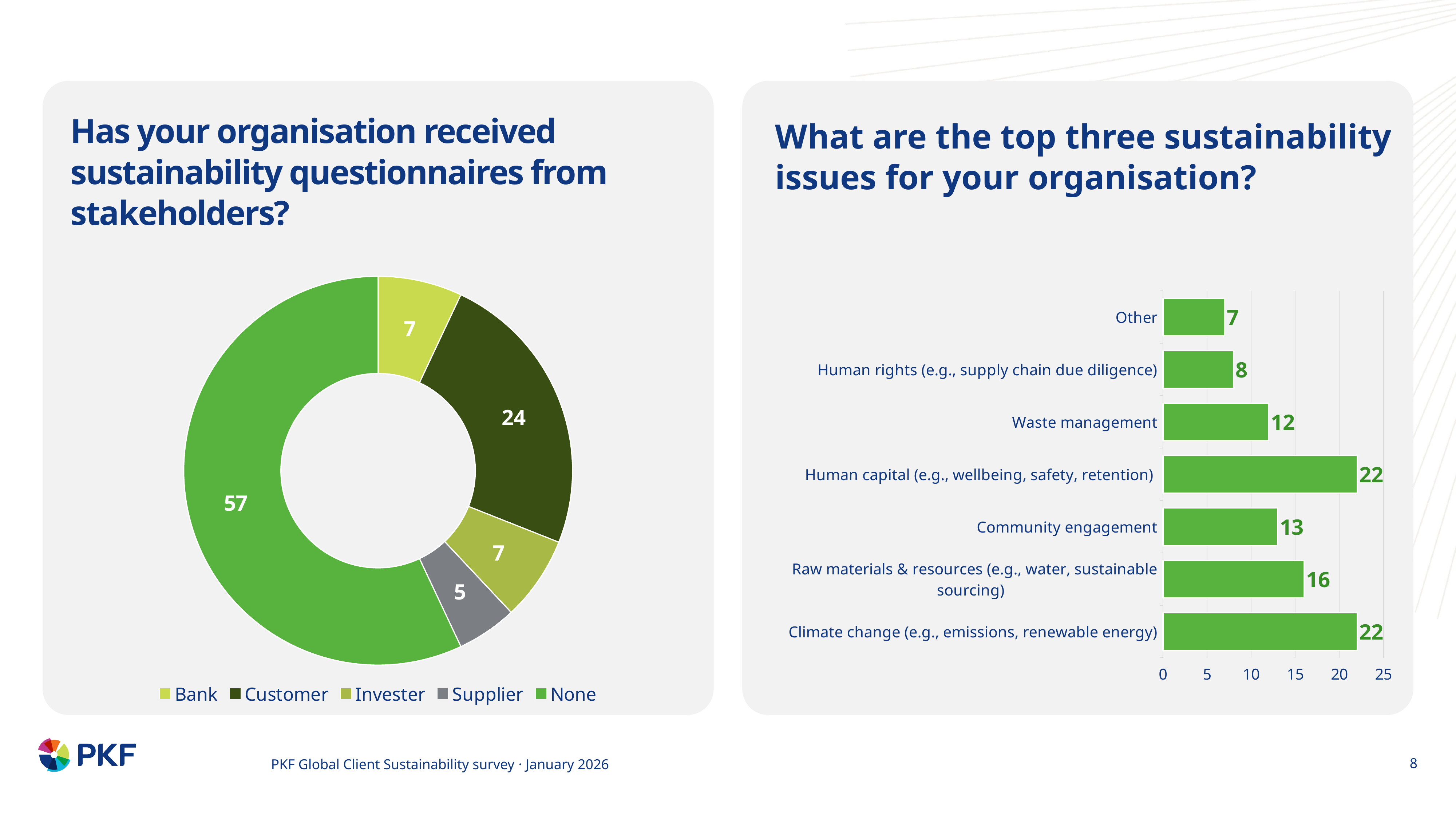
In the left chart, 'Has your organisation received sustainability questionnaires from stakeholders?', how many categories does the legend list? 5 In the left chart, 'Has your organisation received sustainability questionnaires from stakeholders?', what is the value for Customer? 24 In the left chart, 'Has your organisation received sustainability questionnaires from stakeholders?', which category has the smallest value? Supplier In the right chart, 'What are the top three sustainability issues for your organisation?', what is the value for Raw materials & resources? 16 In the right chart, 'What are the top three sustainability issues for your organisation?', which category has the lowest value? Other In the right chart, 'What are the top three sustainability issues for your organisation?', which is larger: Community engagement or Human rights? Community engagement What kind of chart is the left chart, 'Has your organisation received sustainability questionnaires from stakeholders?'? Donut (pie) chart In the left chart, 'Has your organisation received sustainability questionnaires from stakeholders?', what share of the total does the None slice represent? 57% In the right chart, 'What are the top three sustainability issues for your organisation?', what is the value for Waste management? 12 In the left chart, 'Has your organisation received sustainability questionnaires from stakeholders?', what is the difference between the values for None and Customer? 33 In the left chart, 'Has your organisation received sustainability questionnaires from stakeholders?', what is the value for None? 57 What kind of chart is the right chart, 'What are the top three sustainability issues for your organisation?'? Bar chart